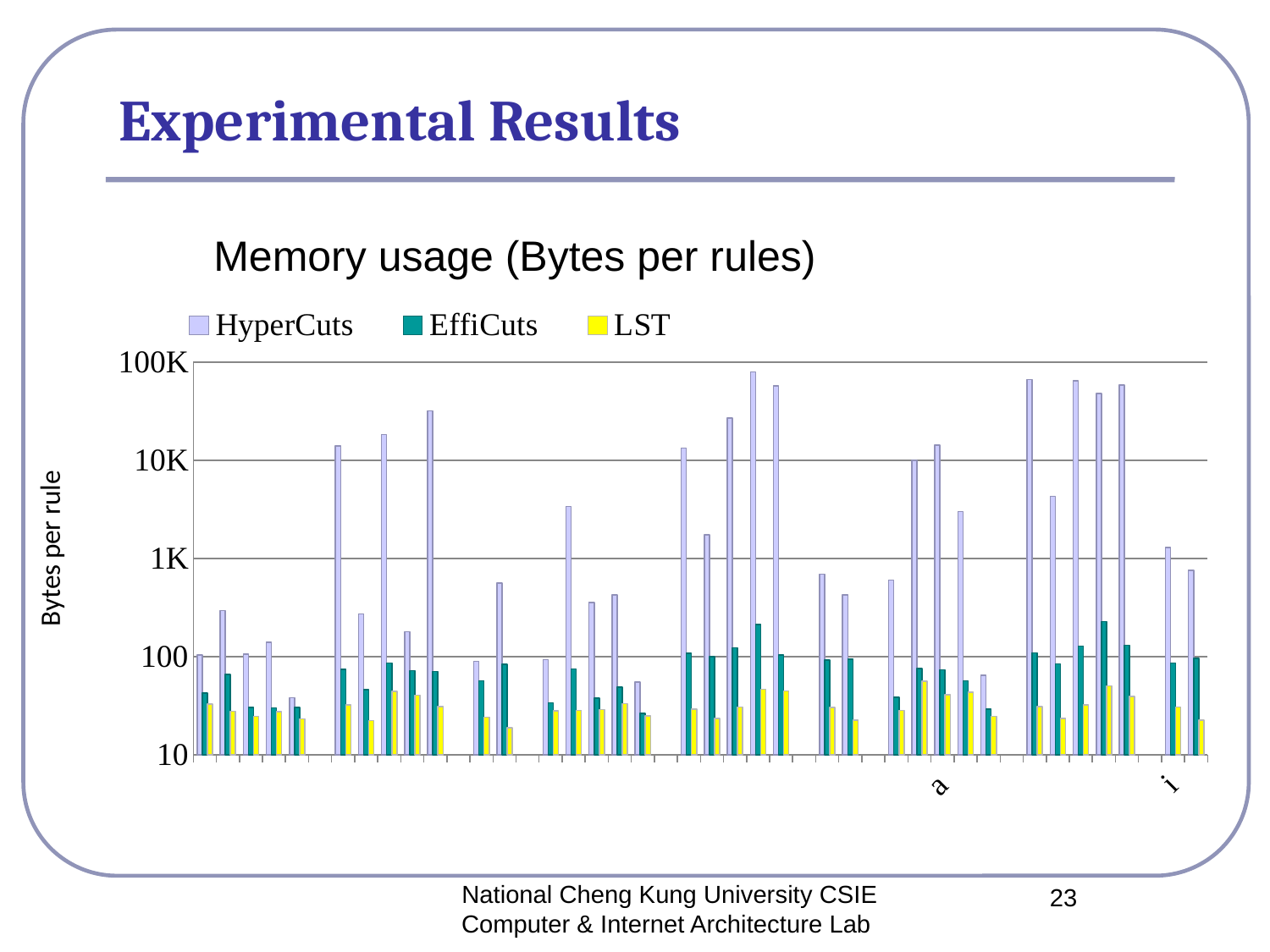
Which series has the lowest values across the chart? LST What is the title of the chart? Memory usage (Bytes per rules) Is the tallest bar on the chart greater or less than 100K? less Is the tallest bar on the chart greater or less than 10K? greater What is the label on the vertical axis of the chart? Bytes per rule Which series generally shows lower values, EffiCuts or LST? LST Is the tallest LST bar greater or less than 100? less How many series does the legend list? 3 Which series has the tallest bar on the chart? HyperCuts What kind of chart is shown on the slide? bar chart Which series generally shows higher values, HyperCuts or EffiCuts? HyperCuts